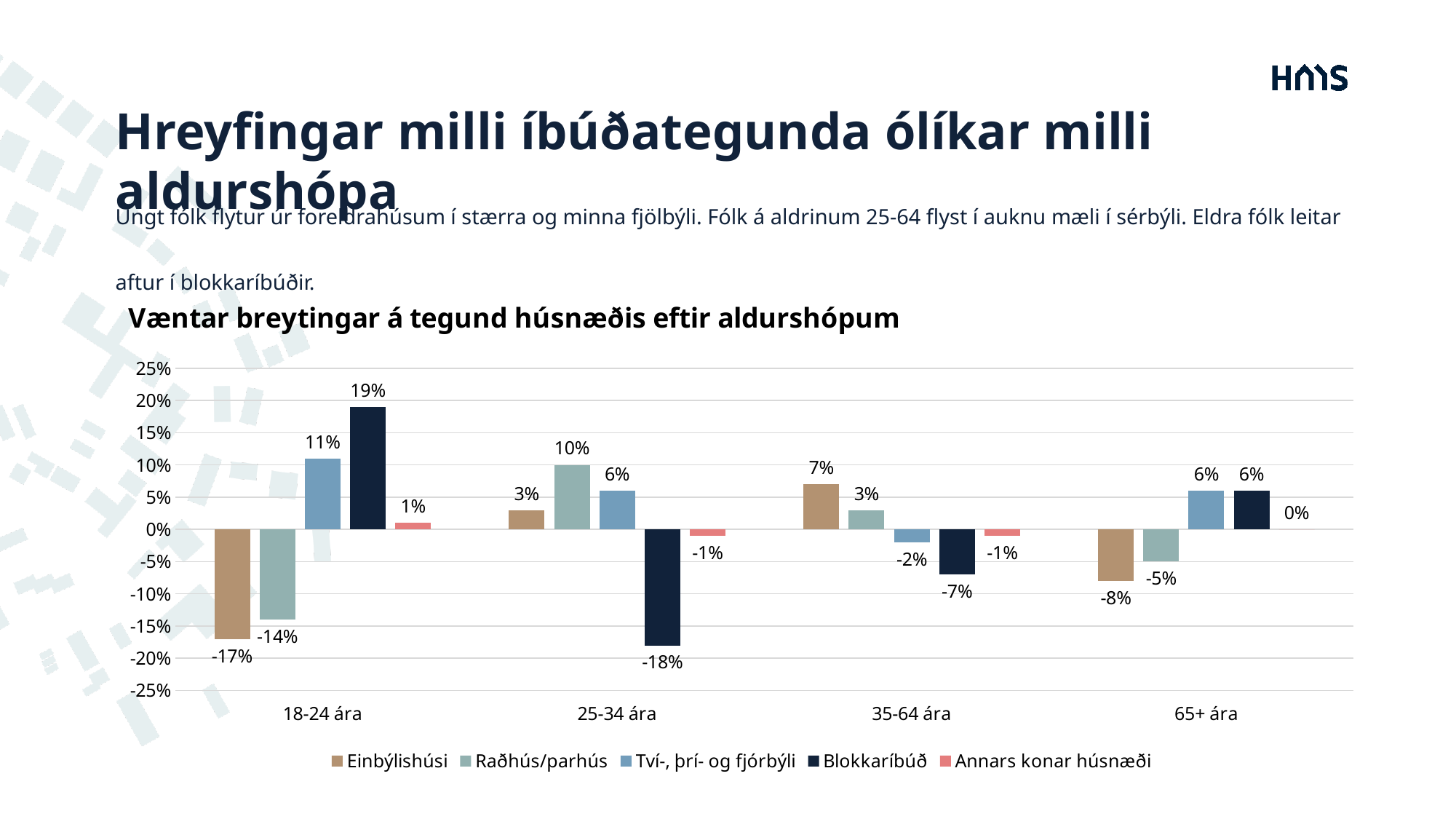
Which is larger: the Einbýlishúsi value for 35-64 ára or the Einbýlishúsi value for 25-34 ára? 35-64 ára What is the value for Blokkaríbúð in the 18-24 ára age group? 19% What is the value for Einbýlishúsi in the 65+ ára age group? -8% What is the title of the chart? Væntar breytingar á tegund húsnæðis eftir aldurshópum Which age group has the highest value for Blokkaríbúð? 18-24 ára What is the value for Raðhús/parhús in the 25-34 ára age group? 10% How many series does the legend list? 5 What is the value for Tví-, þrí- og fjórbýli in the 35-64 ára age group? -2% Which age group has the lowest value for Einbýlishúsi? 18-24 ára How many age groups are shown on the x axis? 4 What kind of chart is shown on the slide? Bar chart What is the difference between the Blokkaríbúð values for 18-24 ára and 25-34 ára? 37 percentage points